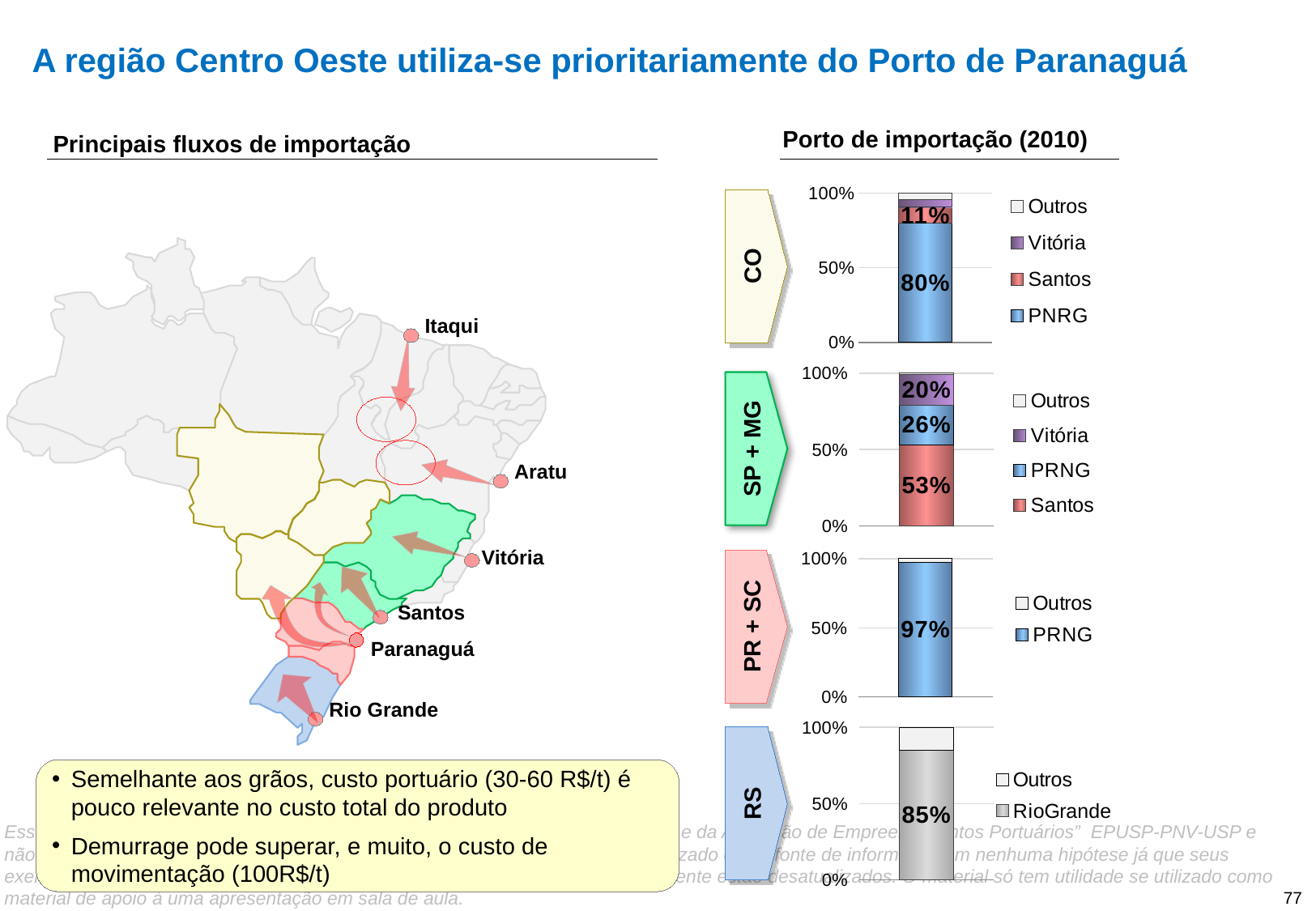
What is the title above the group of bar charts on the right side of the slide? Porto de importação (2010) In the SP + MG chart, what percentage is shown for Santos? 53% In the SP + MG chart, what percentage is shown for PRNG? 26% In the SP + MG chart, what is the difference between the Santos share and the PRNG share? 27% In the CO chart, what percentage is shown for PNRG? 80% In the SP + MG chart, what percentage is shown for Vitória? 20% In the SP + MG chart, which port has the largest share? Santos In the RS chart, what percentage is shown for RioGrande? 85% How many entries does the legend of the CO chart list? 4 Which is larger: the PRNG share in the PR + SC chart or the RioGrande share in the RS chart? PRNG in PR + SC What kind of chart is used for the CO, SP + MG, PR + SC and RS panels? Stacked bar chart In the PR + SC chart, what percentage is shown for PRNG? 97%